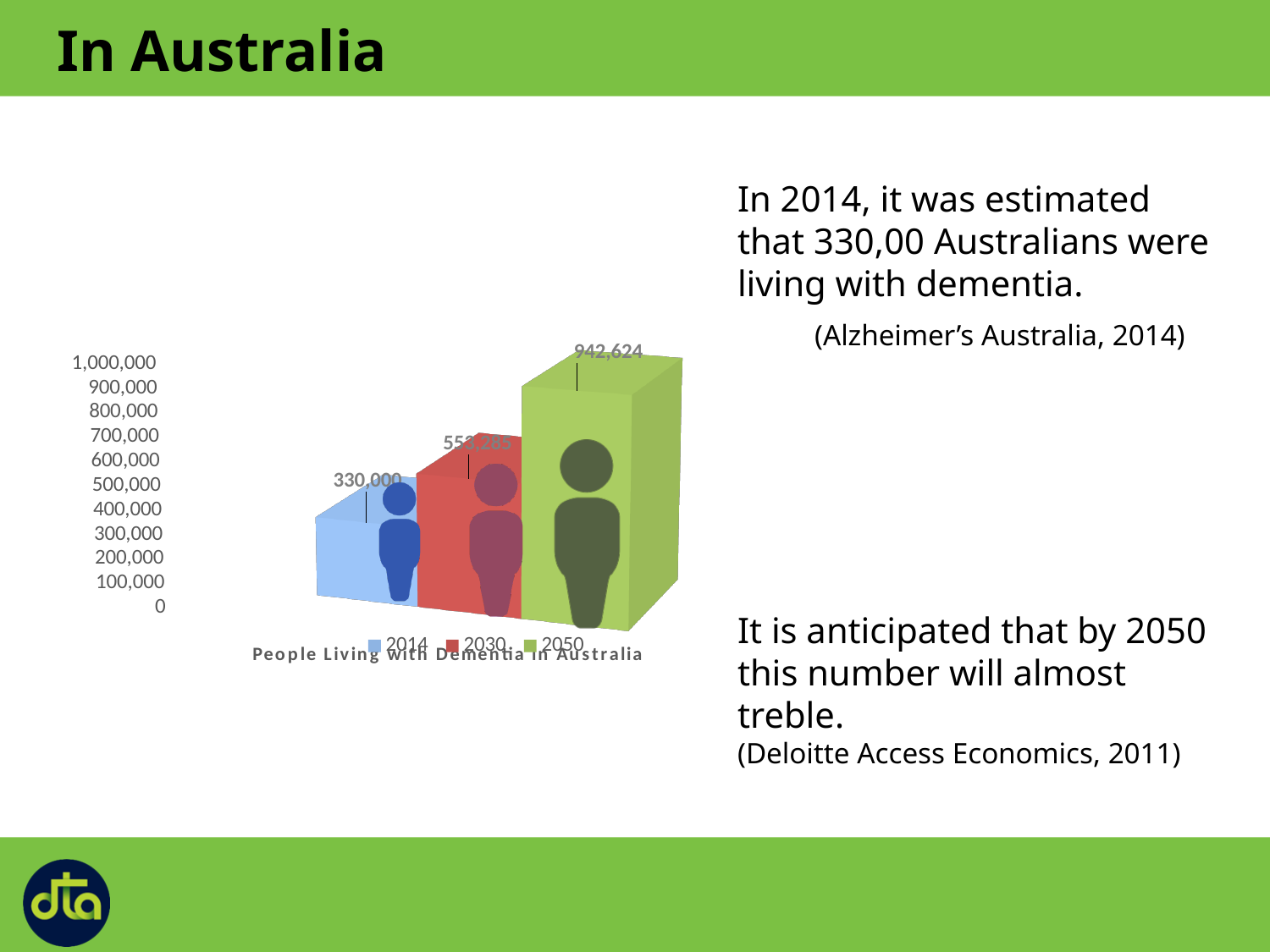
What is the difference between the values for 2050 and 2014? 612,624 What is the value for 2050 in the chart? 942,624 What kind of chart is shown on the slide? Bar chart Is the value for 2030 greater or less than 400,000? greater How many bars are shown in the chart? 3 Which is larger, the value for 2030 or the value for 2014? 2030 How many entries does the chart legend list? 3 Which year has the highest value in the chart? 2050 Which year has the lowest value in the chart? 2014 What is the title of the chart? People Living with Dementia in Australia What is the value for 2014 in the chart? 330,000 Is the value for 2050 greater or less than 900,000? greater